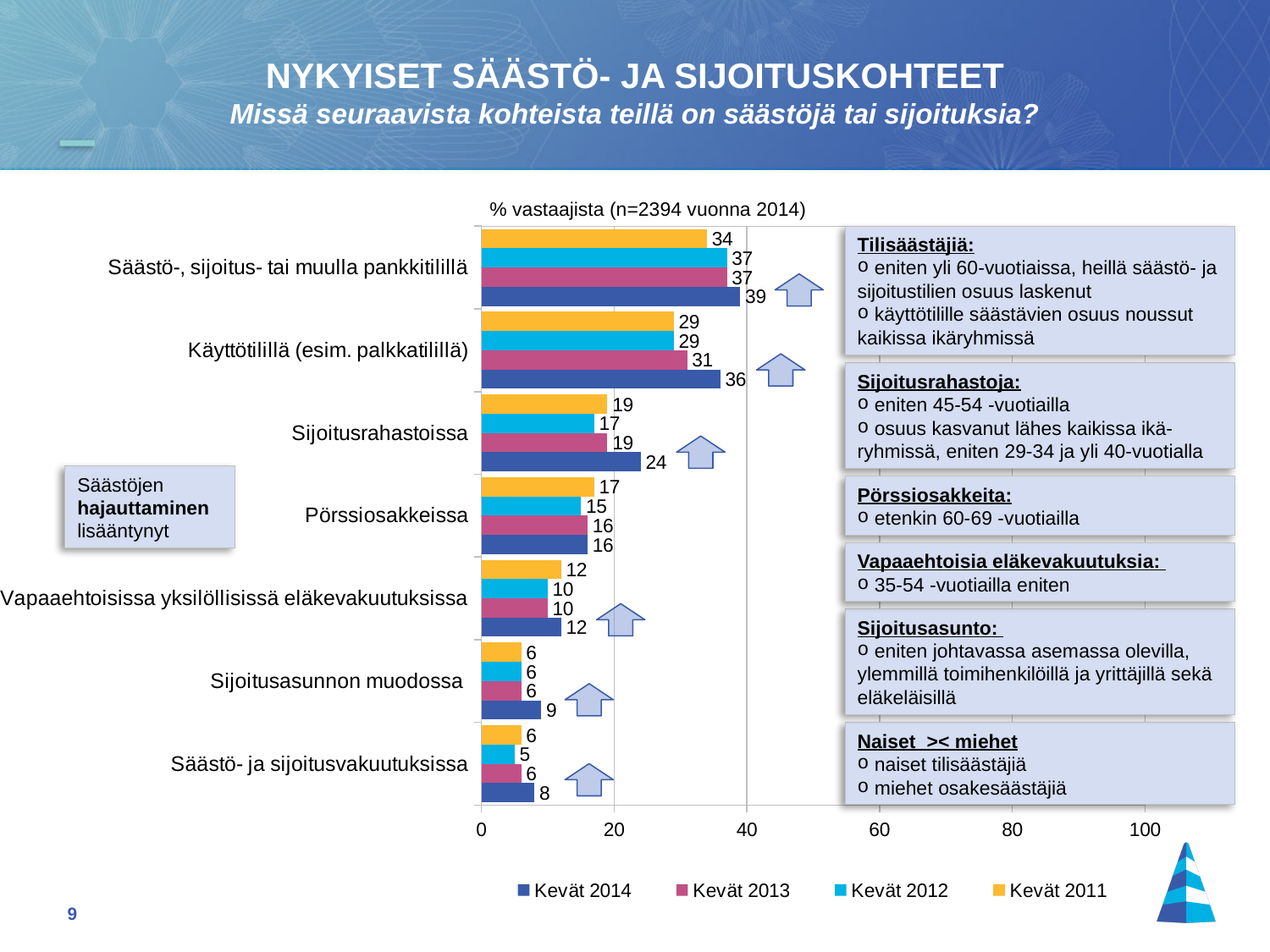
What kind of chart is shown on the slide? bar chart How many categories are shown on the chart? 7 What is the difference between the Kevät 2014 and Kevät 2013 values for Käyttötilillä (esim. palkkatilillä)? 5 Which is larger for Pörssiosakkeissa: the Kevät 2011 value or the Kevät 2012 value? Kevät 2011 What is the Kevät 2014 value for Sijoitusrahastoissa? 24 What is the Kevät 2012 value for Säästö- ja sijoitusvakuutuksissa? 5 What is the Kevät 2014 value for Säästö-, sijoitus- tai muulla pankkitilillä? 39 How many series does the legend list? 4 Which category has the lowest Kevät 2012 value? Säästö- ja sijoitusvakuutuksissa What is the subtitle text shown above the chart? % vastaajista (n=2394 vuonna 2014) What is the Kevät 2011 value for Käyttötilillä (esim. palkkatilillä)? 29 Which category has the highest Kevät 2014 value? Säästö-, sijoitus- tai muulla pankkitilillä